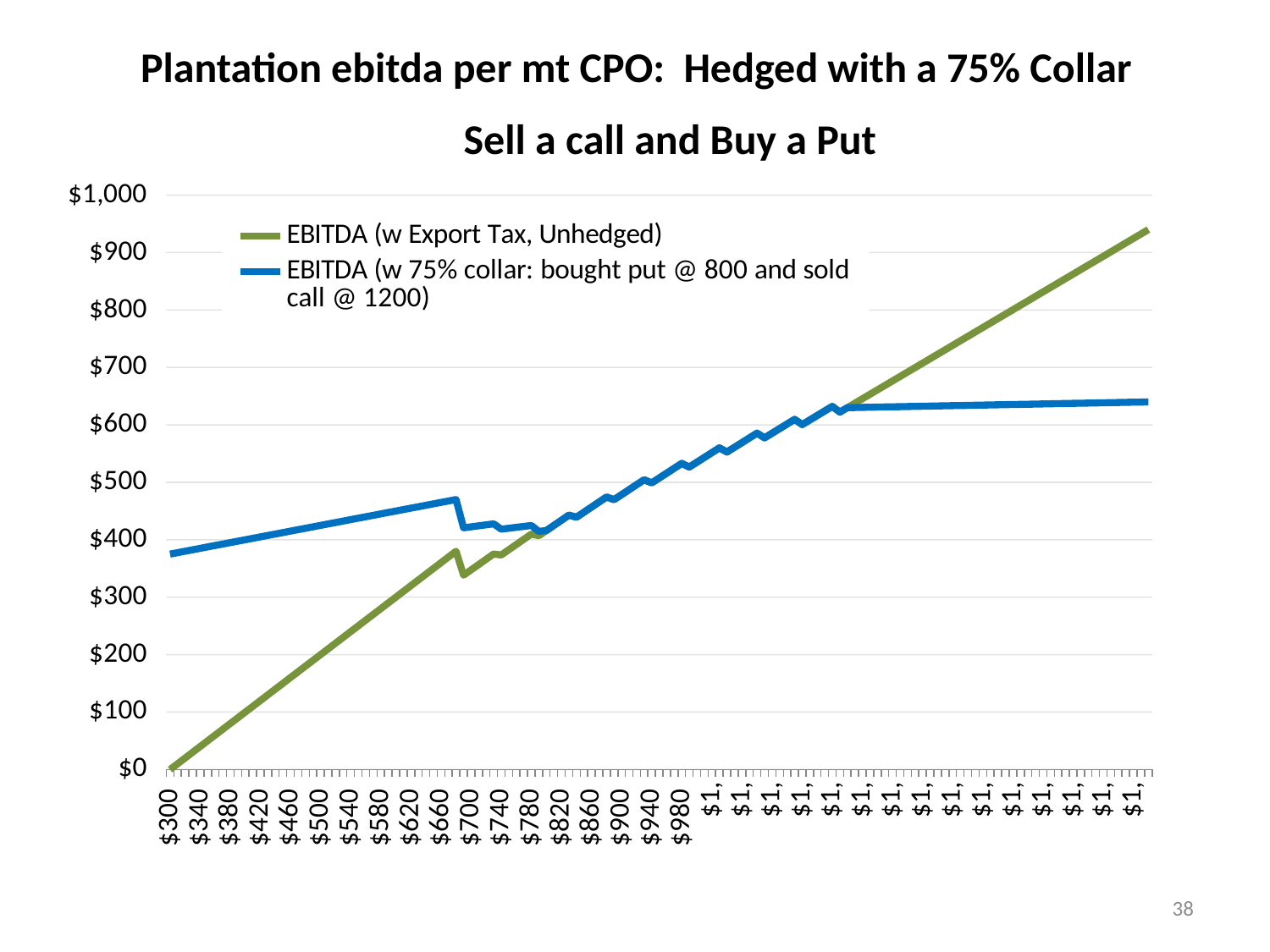
What is the title of the chart? Plantation ebitda per mt CPO: Hedged with a 75% Collar Sell a call and Buy a Put What kind of chart is shown on the slide? Line chart At the right-hand end of the x axis, which series has the higher value: EBITDA (w Export Tax, Unhedged) or EBITDA (w 75% collar)? EBITDA (w Export Tax, Unhedged) Does the EBITDA (w Export Tax, Unhedged) series generally rise or fall as the CPO price increases along the x axis? rise At the right-hand end of the x axis, is the value for EBITDA (w Export Tax, Unhedged) greater or less than $900? greater At a CPO price of $300, is the value for EBITDA (w 75% collar) greater or less than $400? less At a CPO price of $300, is the value for EBITDA (w Export Tax, Unhedged) greater or less than $100? less Which series is drawn in green? EBITDA (w Export Tax, Unhedged) How many series does the legend list? 2 At a CPO price of $300, which series has the higher value: EBITDA (w Export Tax, Unhedged) or EBITDA (w 75% collar)? EBITDA (w 75% collar)